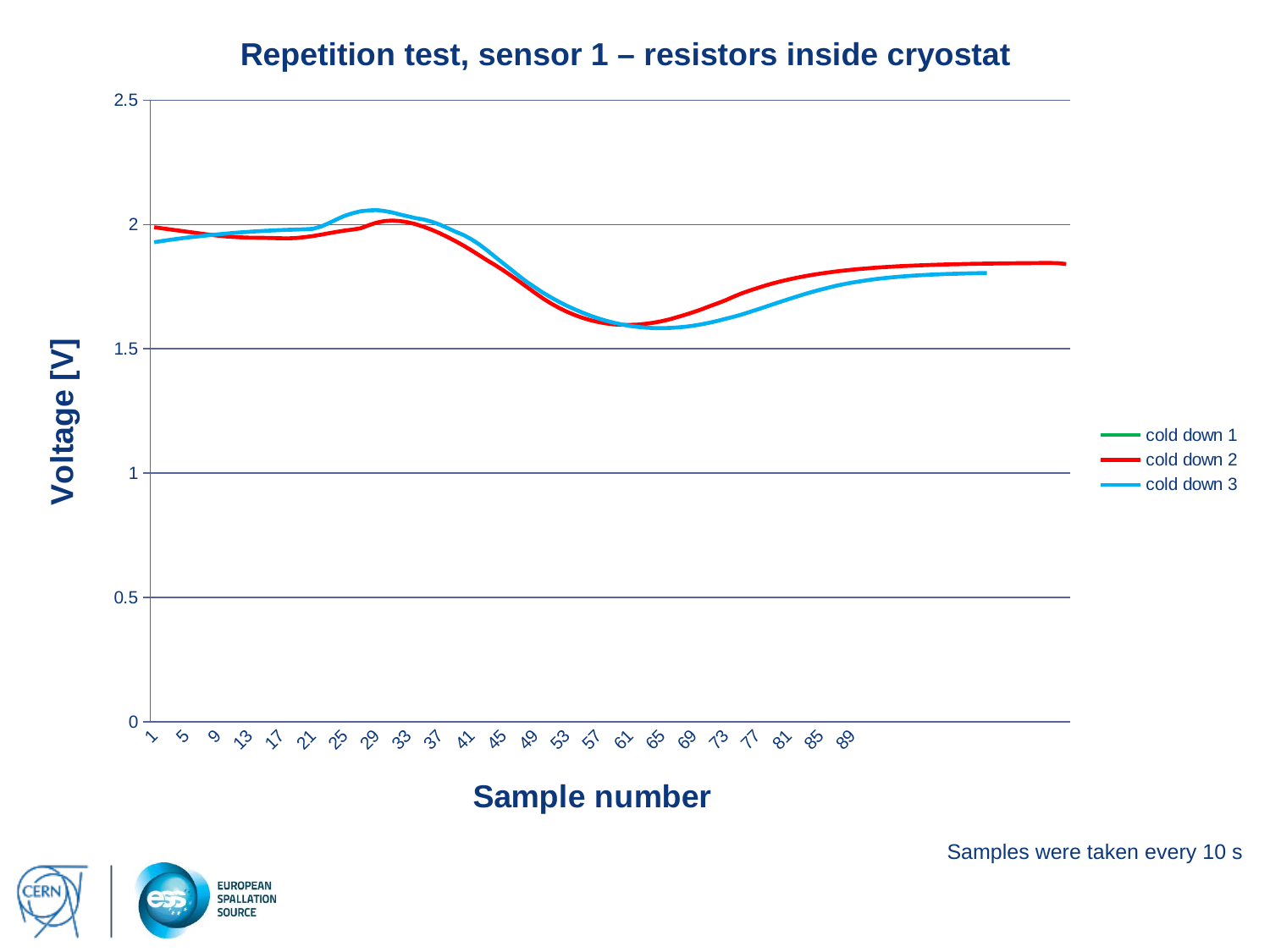
How many series does the legend list? 3 What kind of chart is shown on the slide? line chart At sample 29, which series has the higher voltage, cold down 2 or cold down 3? cold down 3 Does the voltage for cold down 2 rise or fall between sample 33 and sample 61? fall What is the title of the chart? Repetition test, sensor 1 – resistors inside cryostat At sample 77, which series has the higher voltage, cold down 2 or cold down 3? cold down 2 Is the value for cold down 3 at sample 1 greater or less than 2? less Is the value for cold down 2 at sample 89 greater or less than 1.5? greater What is the label of the vertical axis? Voltage [V] Is the value for cold down 3 at sample 45 greater or less than 2? less At sample 1, which series has the higher voltage, cold down 2 or cold down 3? cold down 2